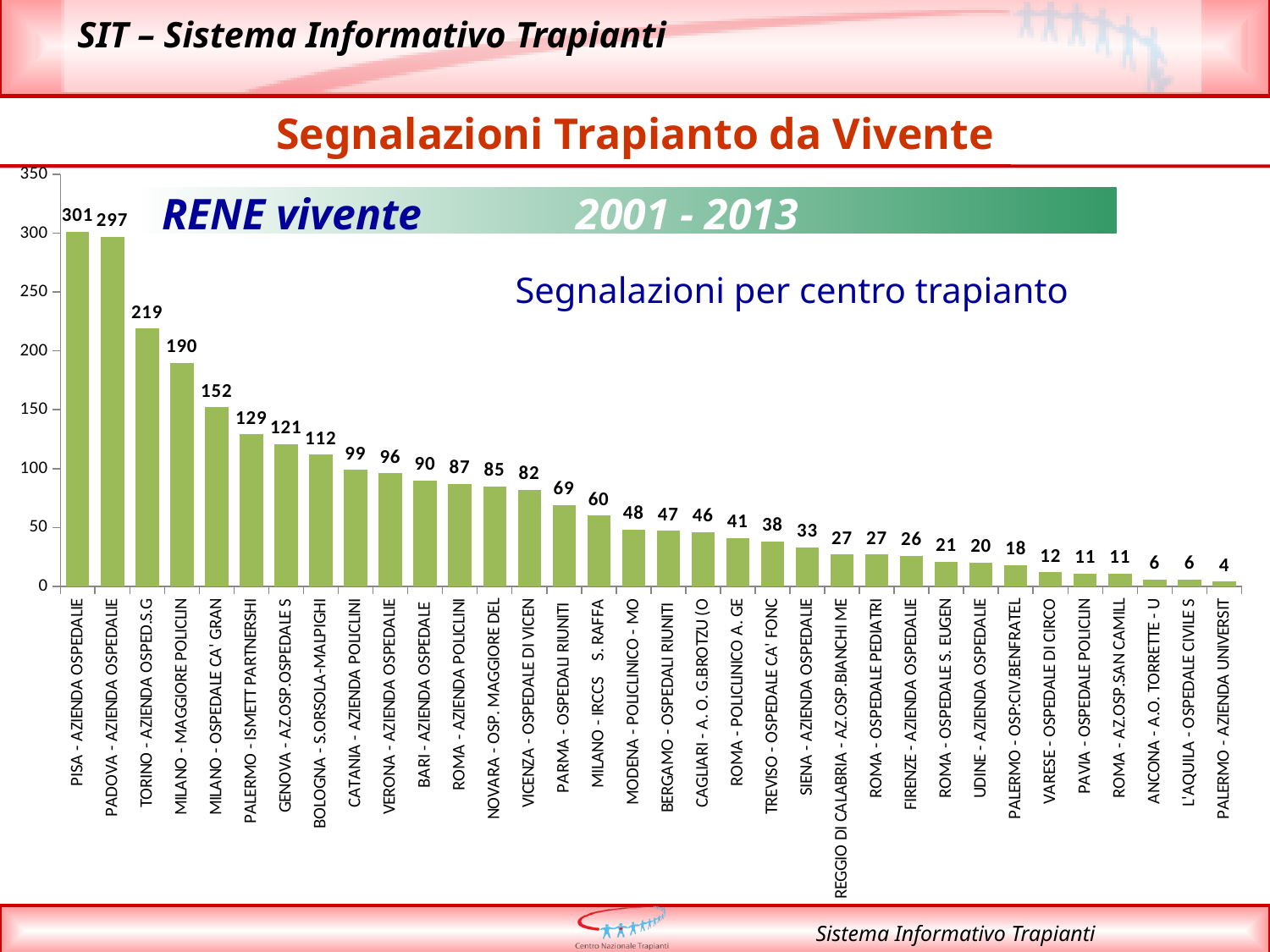
Which centre has the highest number of segnalazioni? PISA - AZIENDA OSPEDALIE What is the difference between the values for PISA - AZIENDA OSPEDALIE and TORINO - AZIENDA OSPED.S.G? 82 What is the difference between the values for MILANO - MAGGIORE POLICLIN and MILANO - OSPEDALE CA' GRAN? 38 What period does the chart cover, according to the label on the chart? 2001 - 2013 What is the value for PISA - AZIENDA OSPEDALIE? 301 What is the value for BOLOGNA - S.ORSOLA-MALPIGHI? 112 What kind of chart is shown on the slide? bar chart Is the value for PALERMO - ISMETT PARTNERSHI greater or less than 100? greater How many transplant centres are shown on the chart? 34 Which centre has the lowest number of segnalazioni? PALERMO - AZIENDA UNIVERSIT What is the value for TREVISO - OSPEDALE CA' FONC? 38 Which is larger, the value for PARMA - OSPEDALI RIUNITI or the value for MILANO - IRCCS S. RAFFA? PARMA - OSPEDALI RIUNITI